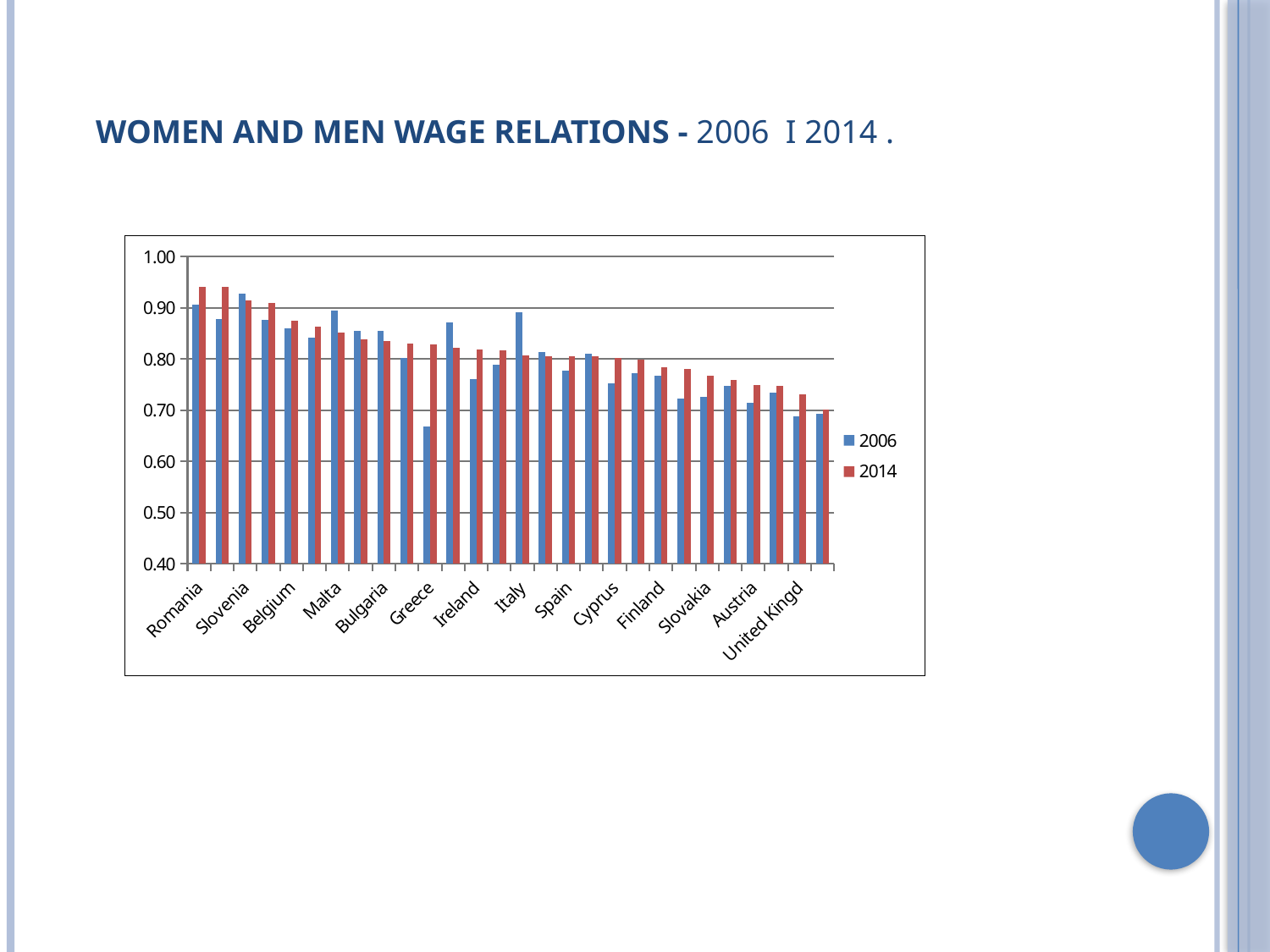
Is the 2006 value for Spain greater or less than 0.80? less For Italy, which is larger, the 2006 value or the 2014 value? 2006 Do the 2014 values generally rise or fall from left to right across the countries? fall How many series does the legend list? 2 Is the 2014 value for Romania greater or less than 0.90? greater Is the 2006 value for Greece greater or less than 0.70? less Which labelled country has the highest 2006 value? Slovenia Which two series are listed in the legend? 2006 and 2014 What kind of chart is shown on the slide? bar chart For Ireland, which is larger, the 2006 value or the 2014 value? 2014 For Greece, which is larger, the 2006 value or the 2014 value? 2014